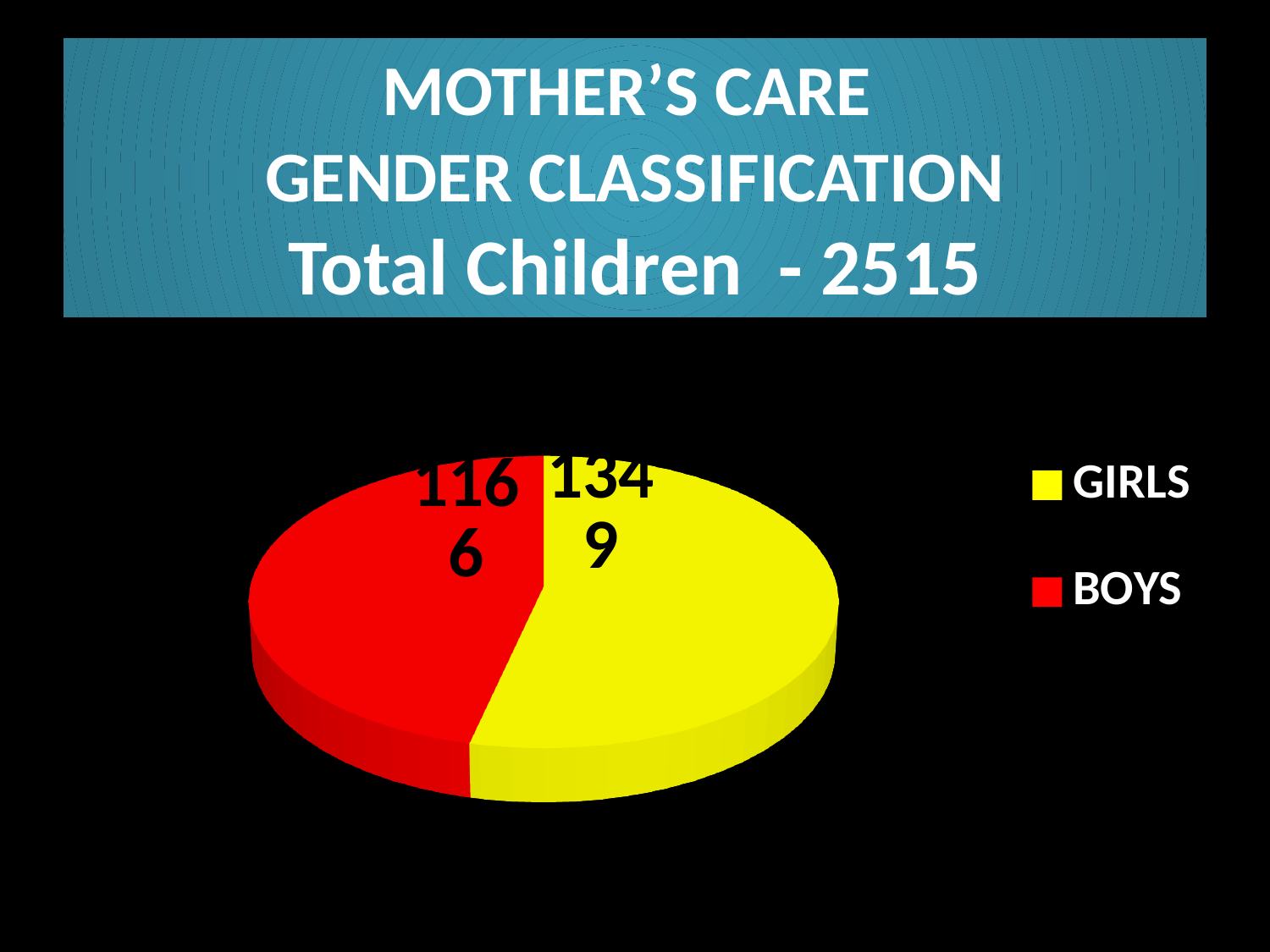
Which category has the largest slice in the pie chart? GIRLS What colour represents BOYS in the pie chart? red What kind of chart is shown on the slide? pie chart What is the difference between the GIRLS value and the BOYS value? 183 Which category has the smallest slice in the pie chart? BOYS Which category has the larger slice, GIRLS or BOYS? GIRLS How many slices does the pie chart have? 2 What colour represents GIRLS in the pie chart? yellow What is the value for BOYS in the pie chart? 1166 What is the value for GIRLS in the pie chart? 1349 How many entries does the legend list? 2 What is the total number of children stated in the slide title? 2515